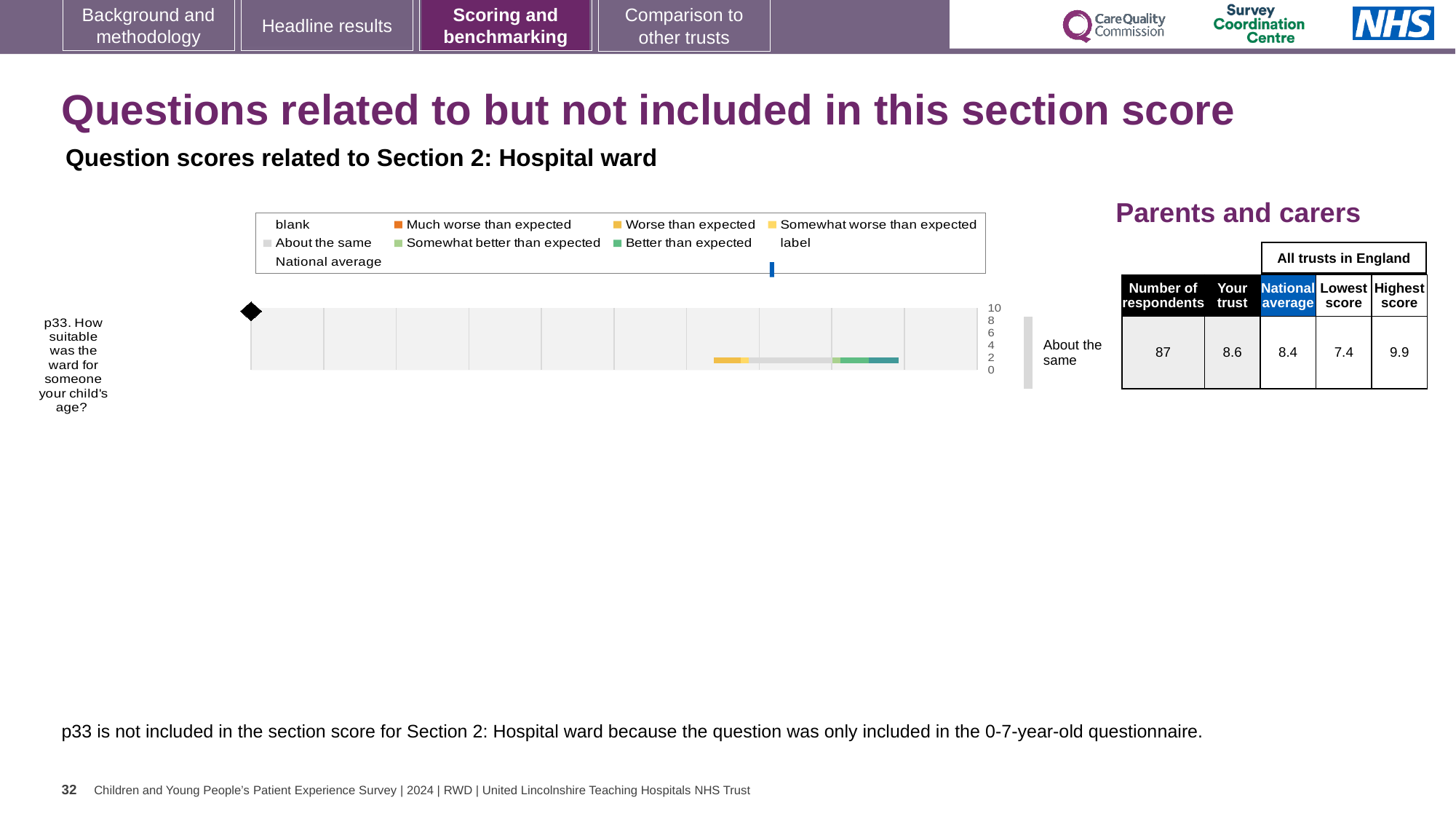
What kind of chart is used to show the score for question p33? bar chart How many questions are plotted in the chart? 1 What is the 'Your trust' score for question p33? 8.6 What is the highest score among all trusts in England for question p33? 9.9 What is the difference between the highest score and the lowest score for question p33? 2.5 How many respondents answered question p33? 87 Which question is plotted in the chart? p33. How suitable was the ward for someone your child's age? What benchmark category is shown next to the bar for question p33? About the same What is the maximum value shown on the chart's score axis? 10 What is the national average score for question p33? 8.4 Which is larger for question p33, the 'Your trust' score or the national average? Your trust What is the lowest score among all trusts in England for question p33? 7.4